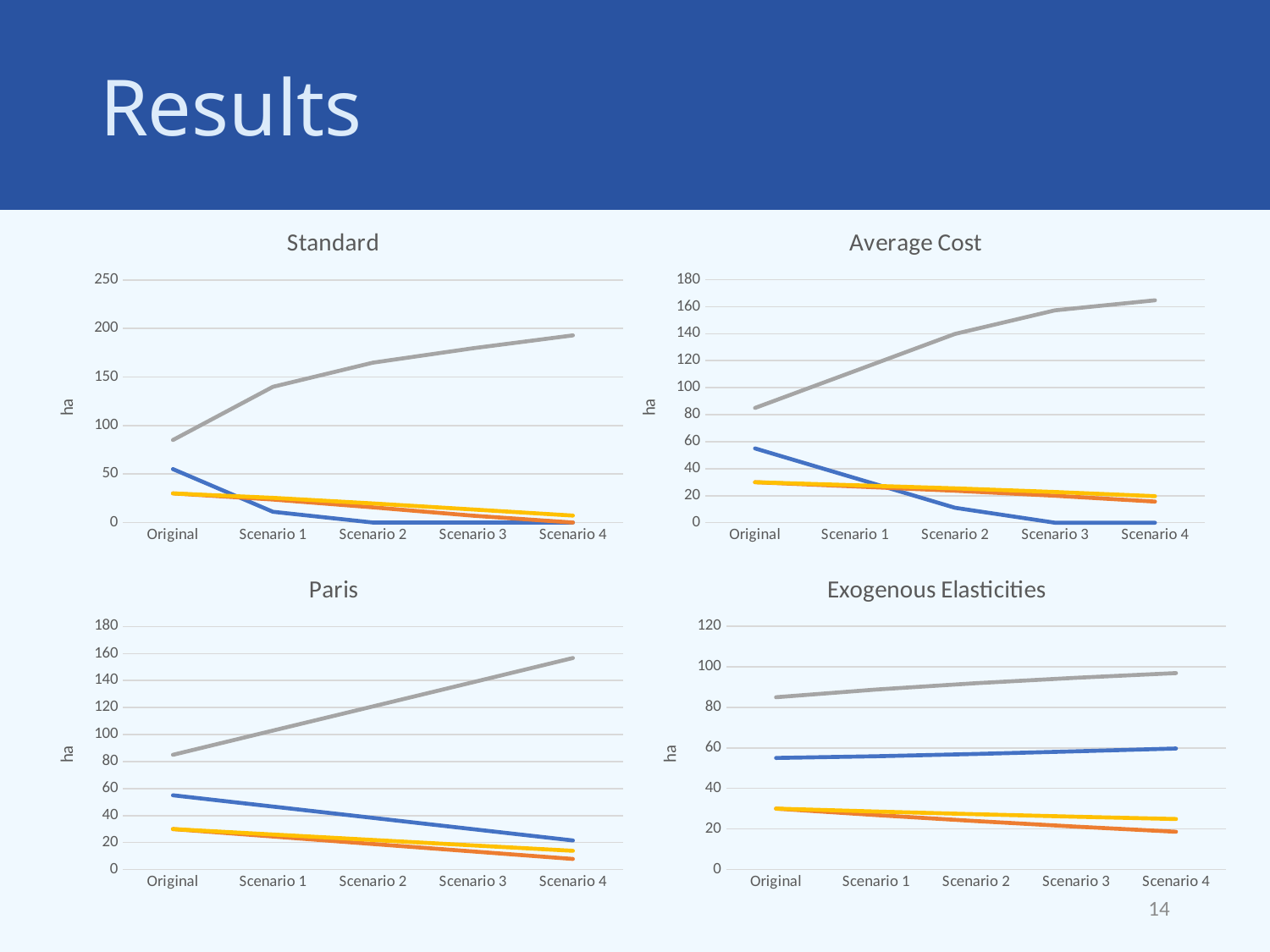
In the "Paris" chart, is the value of the gray line at Scenario 4 greater or less than 140? greater In the "Paris" chart, does the blue line rise or fall from Original to Scenario 4? fall What is the title of the chart in the top right of the slide? Average Cost In the "Standard" chart, does the gray line rise or fall from Original to Scenario 4? rise In the "Average Cost" chart, does the gray line rise or fall across the scenarios? rise How many categories are shown on the x axis of the "Paris" chart? 5 What kind of chart is the "Standard" chart? line chart In the "Exogenous Elasticities" chart, is the value of the gray line at Original greater or less than 100? less In the "Standard" chart, is the value of the gray line at Scenario 4 greater or less than 150? greater What is the y-axis label on the "Exogenous Elasticities" chart? ha